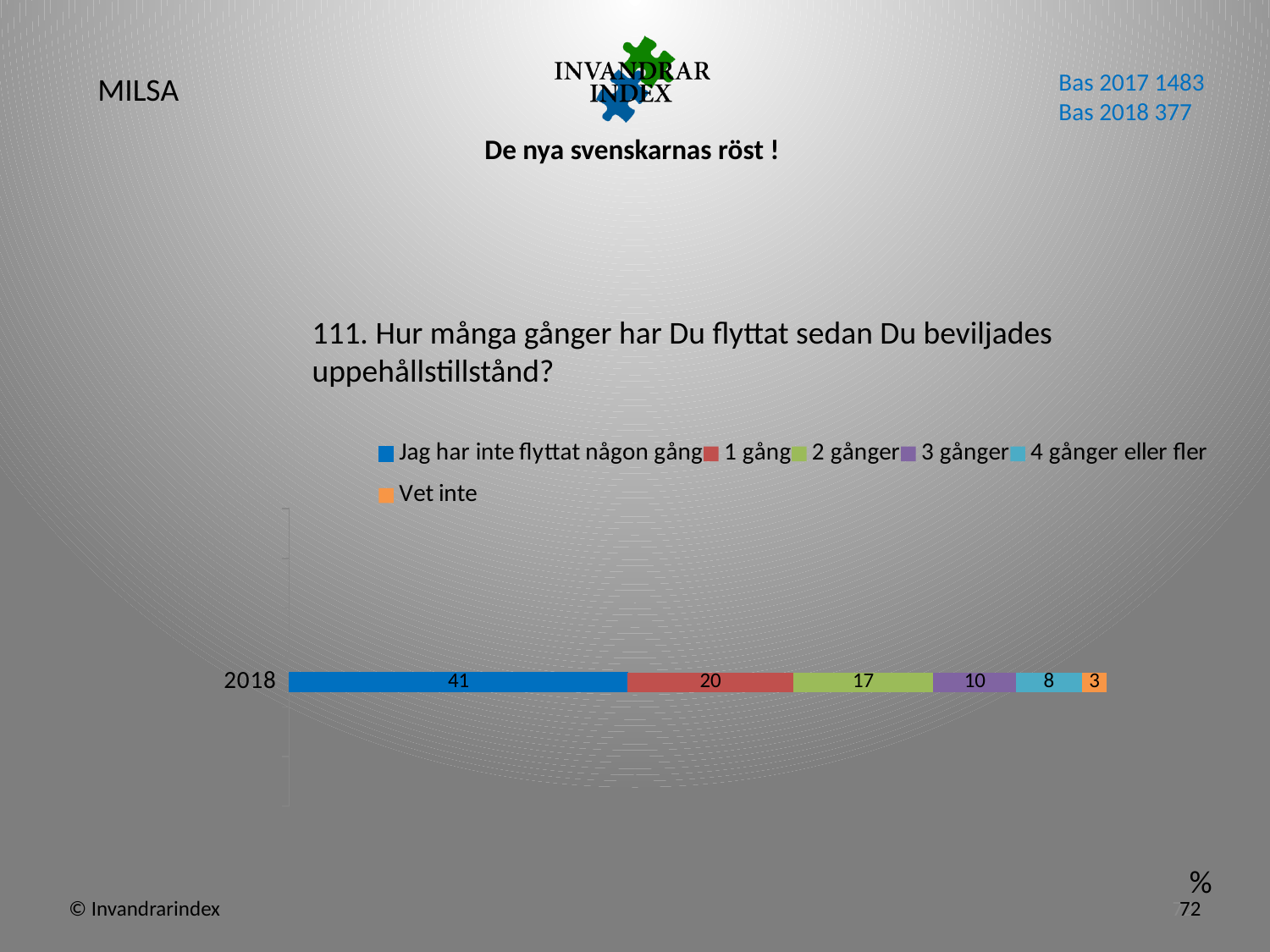
What value is shown for "Vet inte" in the 2018 bar? 3 What value is shown for "1 gång" in the 2018 bar? 20 Which legend category has the smallest segment in the 2018 bar? Vet inte What is the total of all segments in the 2018 stacked bar? 99 What value is shown for "3 gånger" in the 2018 bar? 10 What kind of chart is shown on the slide? Stacked bar chart How many series does the legend list? 6 Which is larger in the 2018 bar: "2 gånger" or "3 gånger"? 2 gånger What value is shown for "2 gånger" in the 2018 bar? 17 Which legend category has the largest segment in the 2018 bar? Jag har inte flyttat någon gång What value is shown for "Jag har inte flyttat någon gång" in the 2018 bar? 41 What is the difference between the values for "1 gång" and "4 gånger eller fler" in the 2018 bar? 12